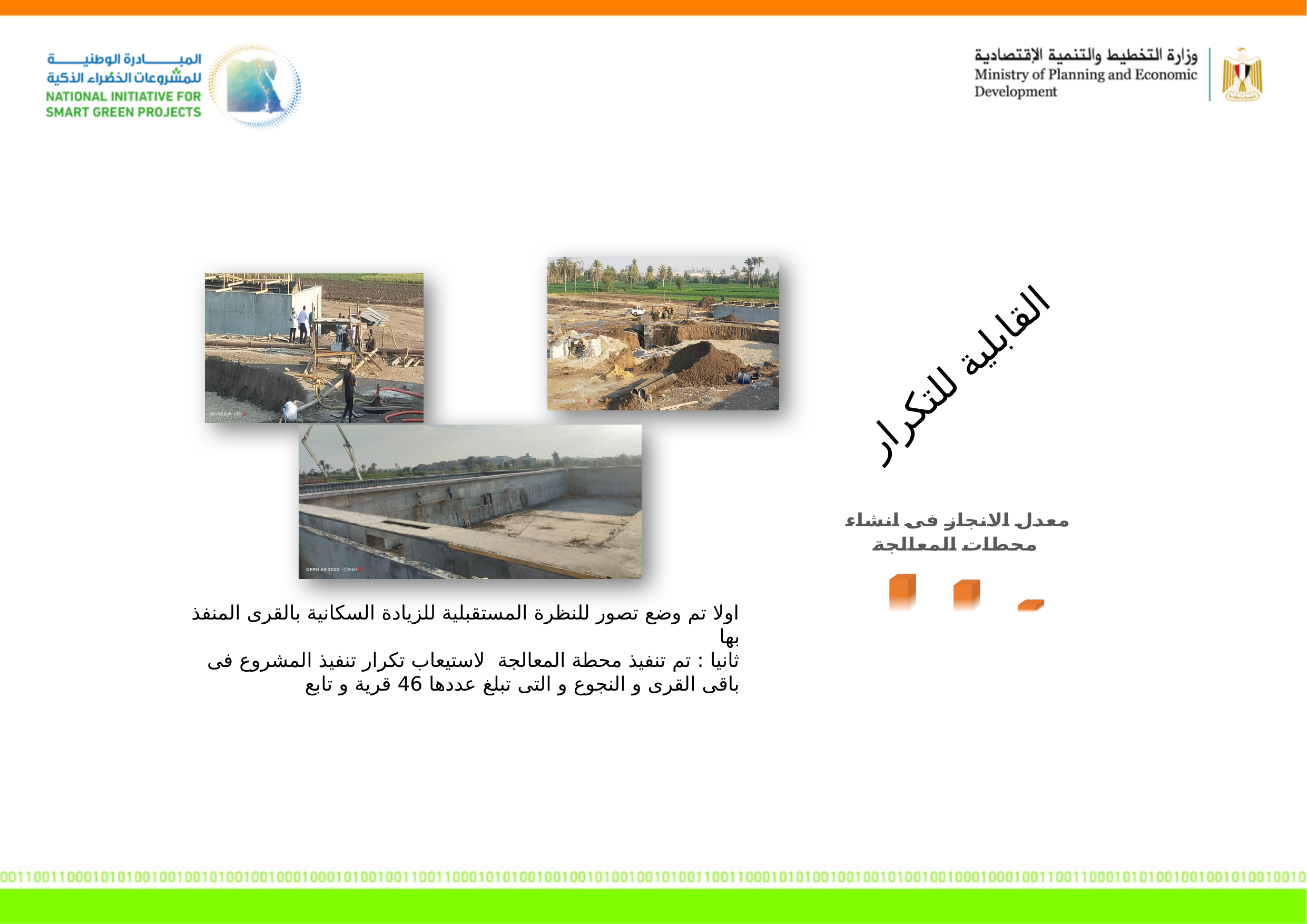
In the chart, is the middle bar taller or shorter than the rightmost bar? taller Do the bar heights in the chart rise or fall from left to right? fall Which bar in the chart is the tallest: the leftmost, the middle, or the rightmost? leftmost What is the title of the chart on the slide? معدل الانجاز فى انشاء محطات المعالجة How many bars does the chart on the slide contain? 3 What kind of chart is shown on the slide under the heading معدل الانجاز فى انشاء محطات المعالجة? bar chart What colour are the bars in the chart on the slide? orange Which bar in the chart is the shortest: the leftmost, the middle, or the rightmost? rightmost